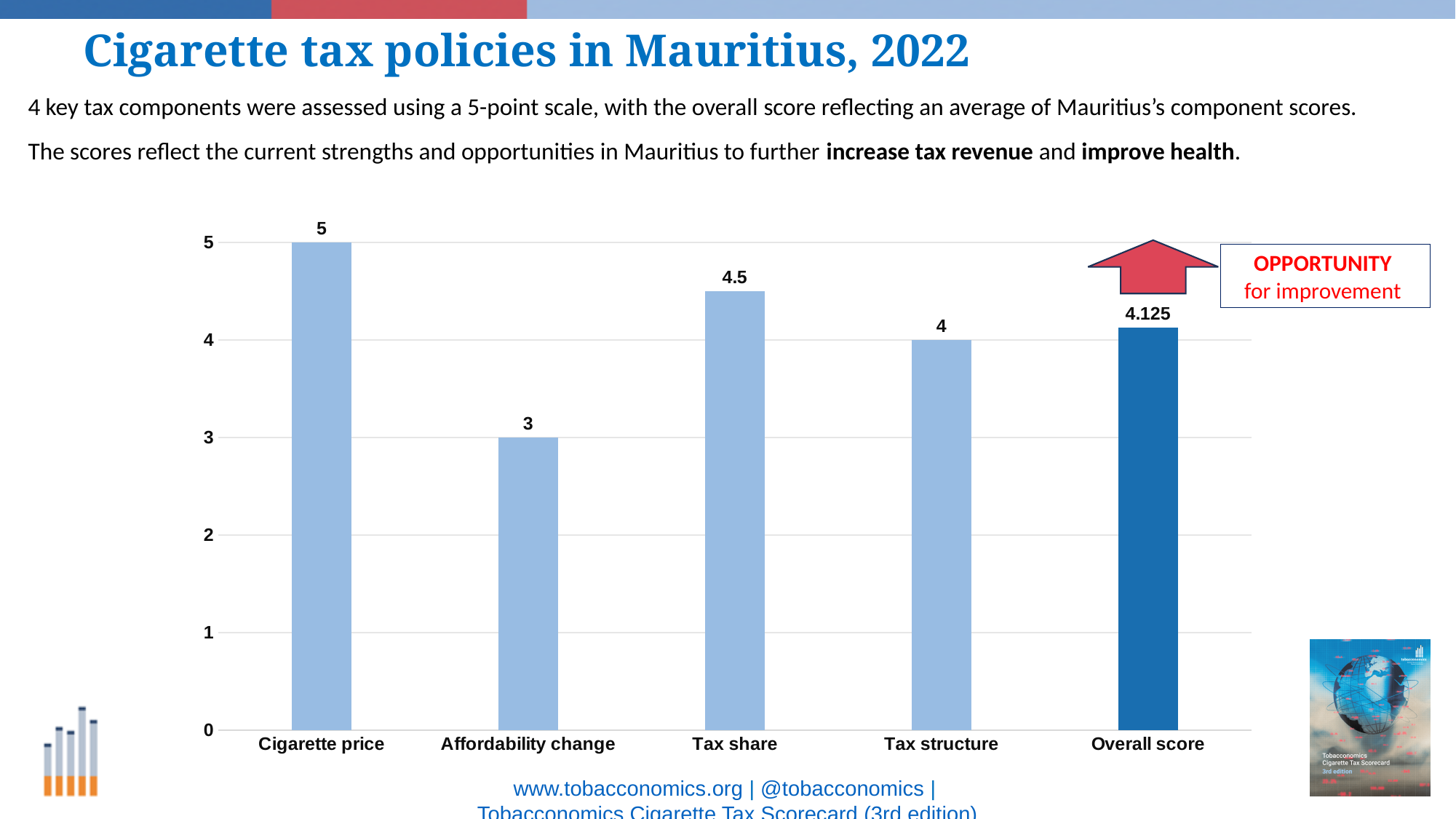
Which is larger, the value for Tax share or the value for Tax structure? Tax share What is the difference between the values for Cigarette price and Affordability change? 2 What is the value for Tax share? 4.5 What is the value for Tax structure? 4 What is the Overall score? 4.125 What is the value for Cigarette price? 5 Which category has the lowest value? Affordability change Which category has the highest value? Cigarette price Which bar is shown in a darker blue than the others? Overall score What is the value for Affordability change? 3 How many bars are shown in the chart? 5 What kind of chart is shown on the slide? Bar chart